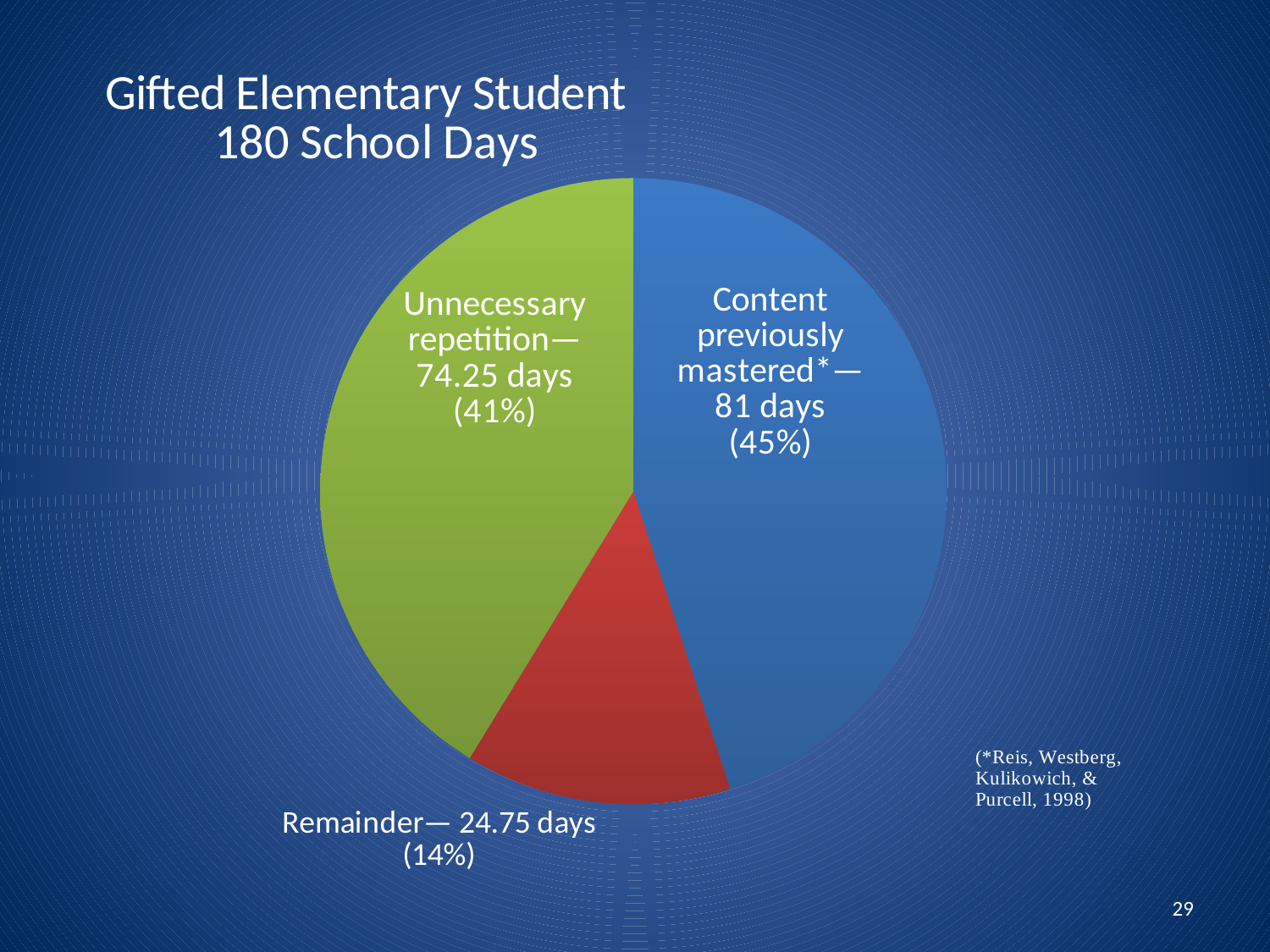
How many slices does the pie chart have? 3 What percentage share of the pie is Content previously mastered? 45% How many days are labelled for Unnecessary repetition? 74.25 days What is the title of the chart? Gifted Elementary Student 180 School Days What percentage share of the pie is Unnecessary repetition? 41% Which slice of the pie is the smallest? Remainder What percentage share of the pie is Remainder? 14% Which slice of the pie is the largest? Content previously mastered What kind of chart is shown on the slide? pie chart What is the difference in days between Unnecessary repetition and Remainder? 49.5 days How many days are labelled for Content previously mastered? 81 days How many days are labelled for Remainder? 24.75 days